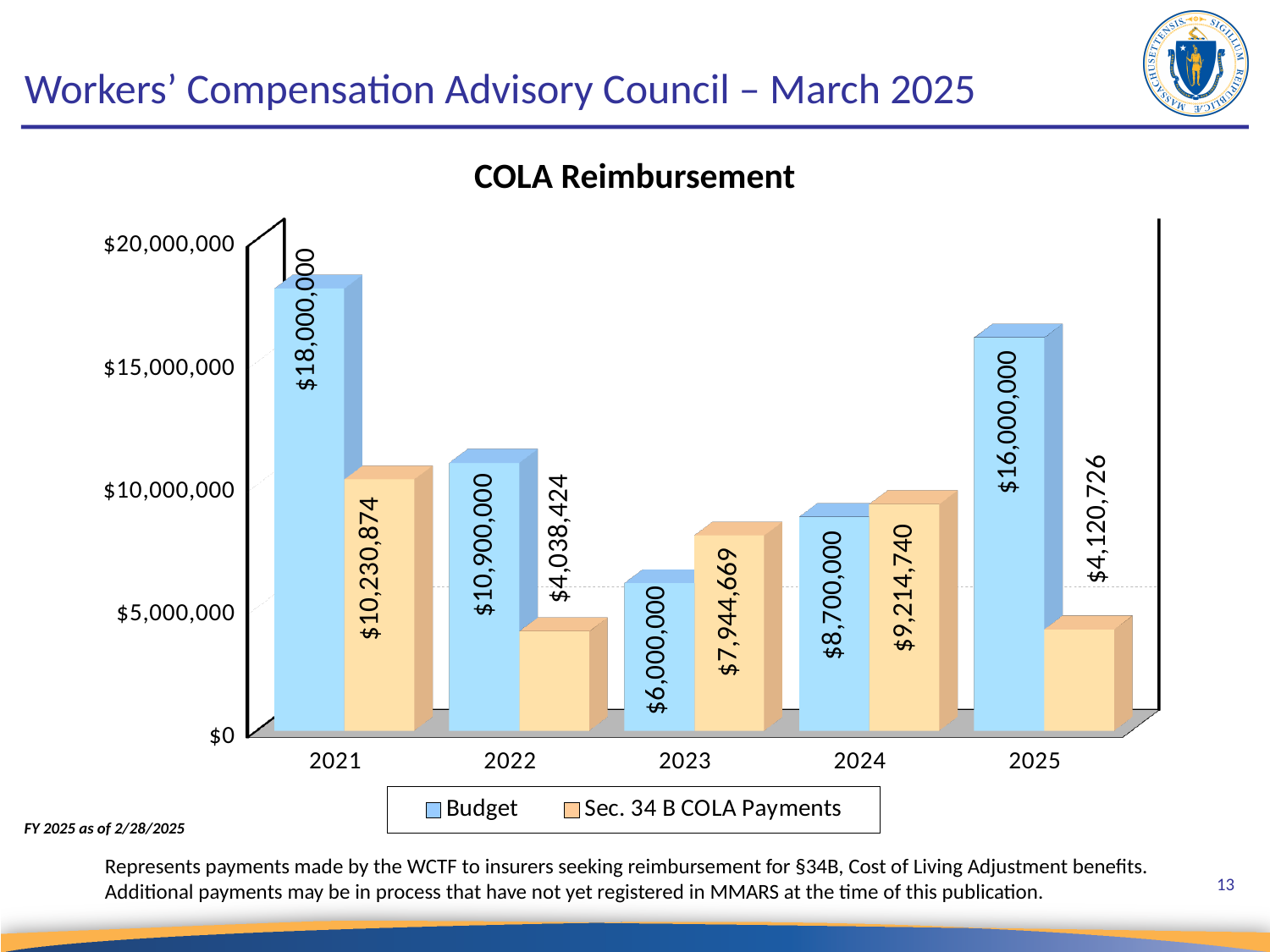
Which year has the highest Budget value? 2021 What is the Sec. 34 B COLA Payments value for 2023? $7,944,669 What is the difference between the Budget and the Sec. 34 B COLA Payments in 2024? $514,740 What kind of chart is shown? Bar chart What is the Budget value for 2021? $18,000,000 What is the title of the chart? COLA Reimbursement Is the Budget value for 2025 greater or less than $15,000,000? greater How many years are shown on the x axis? 5 Which year has the lowest Sec. 34 B COLA Payments value? 2022 In 2023, which is larger: the Budget or the Sec. 34 B COLA Payments? Sec. 34 B COLA Payments What is the Sec. 34 B COLA Payments value for 2025? $4,120,726 How many series does the legend list? 2